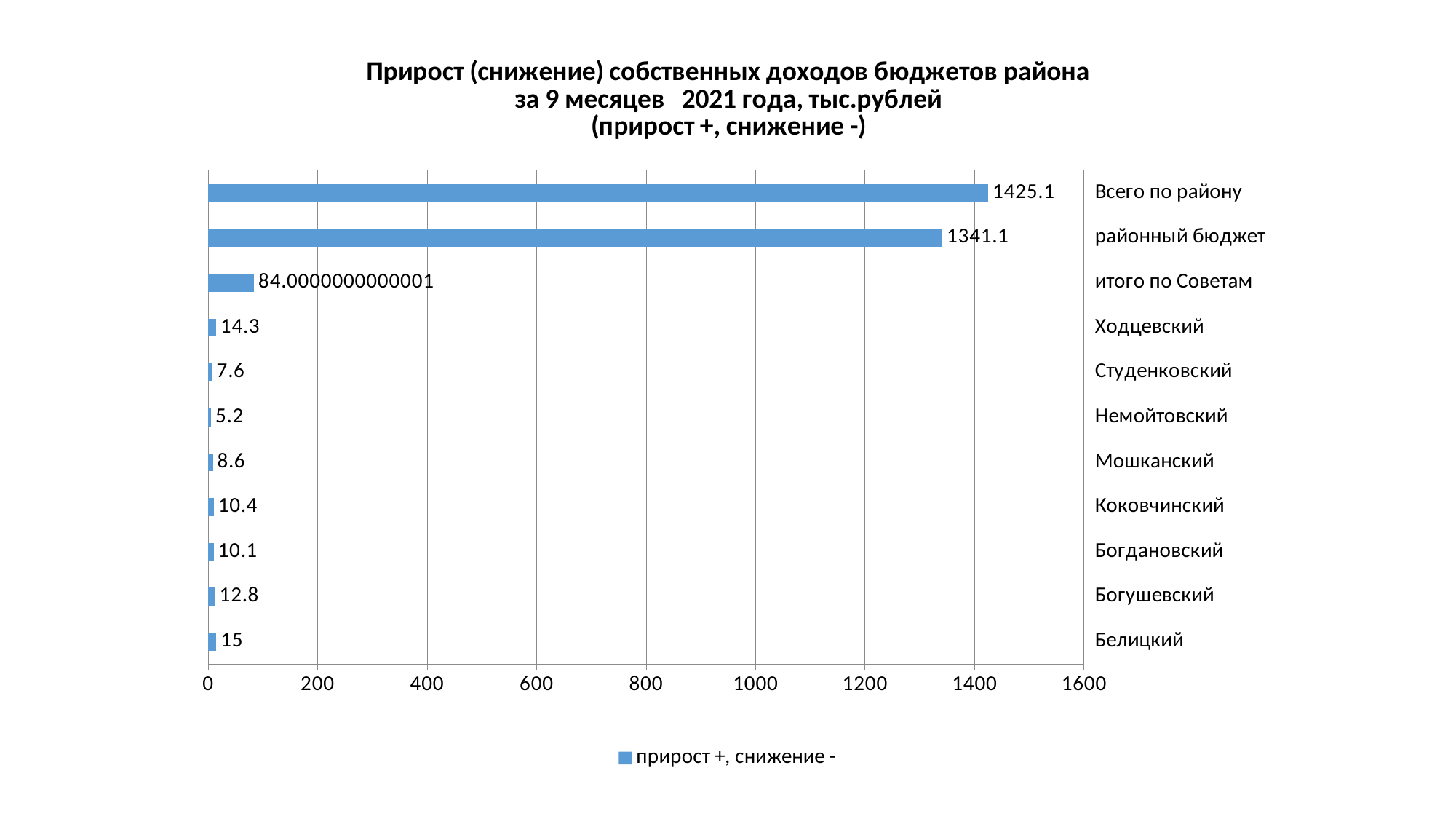
Which is larger, the value for Белицкий or the value for Богушевский? Белицкий How many categories are shown in the chart? 11 What is the value for Немойтовский? 5.2 Which category has the lowest value? Немойтовский What is the difference between the values for Всего по району and районный бюджет? 84 Which category has the highest value? Всего по району What is the value for Ходцевский? 14.3 What is the value for Всего по району? 1425.1 What is the value for районный бюджет? 1341.1 What kind of chart is shown on the slide? bar chart Is the value for итого по Советам greater or less than 200? less What is the legend entry shown below the chart? прирост +, снижение -